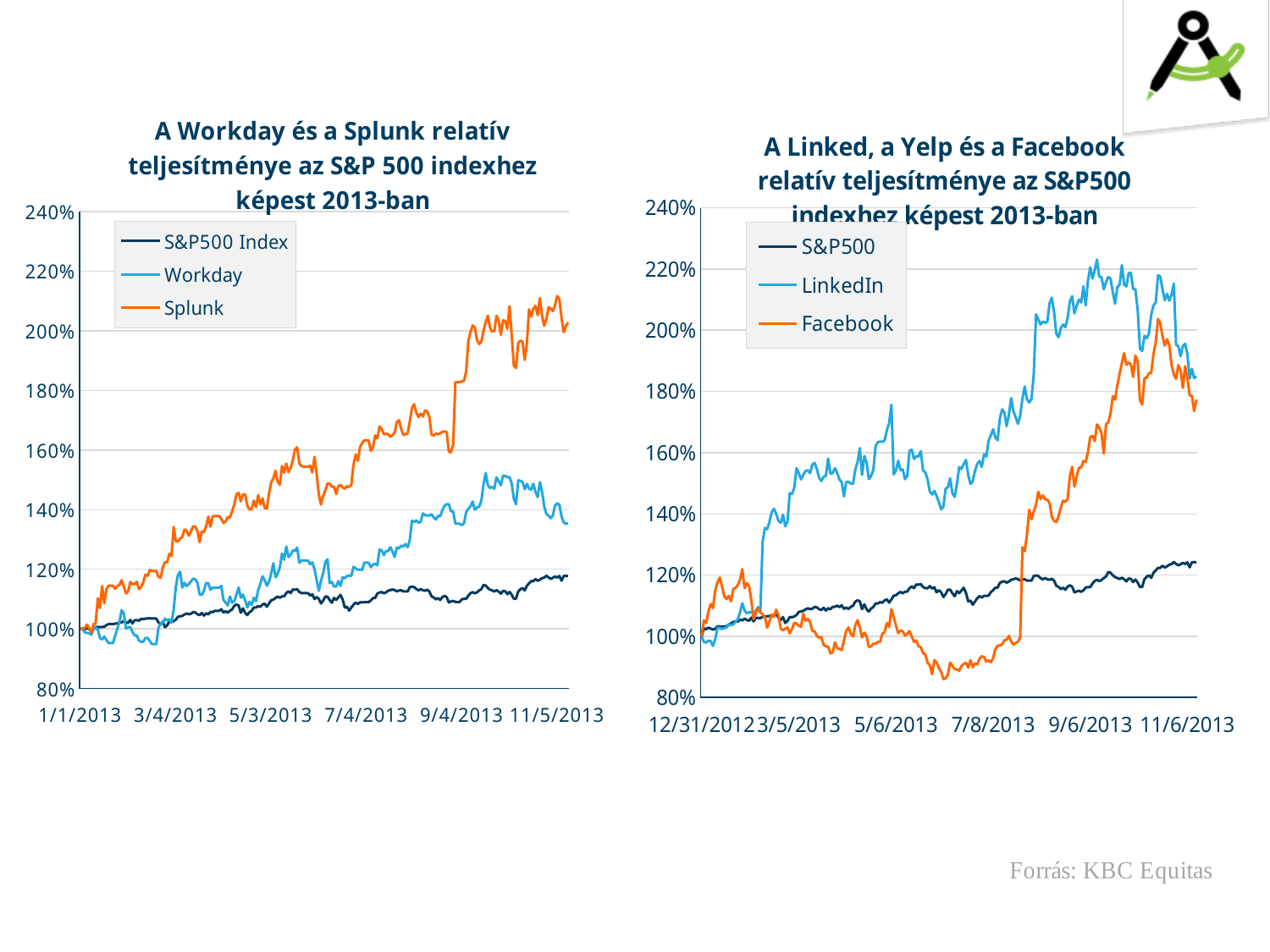
How many series does the legend of the left chart list? 3 In the right chart, is the peak value of LinkedIn greater or less than 200%? greater Which series is drawn in orange in the right chart? Facebook In the right chart, which series reaches the highest value during 2013? LinkedIn How many series does the legend of the right chart list? 3 What kind of chart is the left chart, 'A Workday és a Splunk relatív teljesítménye az S&P 500 indexhez képest 2013-ban'? line chart In the right chart, does the S&P500 line generally rise or fall over the course of 2013? rise In the left chart, is the value of Workday at the end of the period greater or less than 160%? less In the left chart, is the value of Splunk at the end of the period (November 2013) greater or less than 180%? greater In the left chart, which series is higher at the end of the period, Splunk or Workday? Splunk In the left chart, which series reaches the highest value during 2013? Splunk